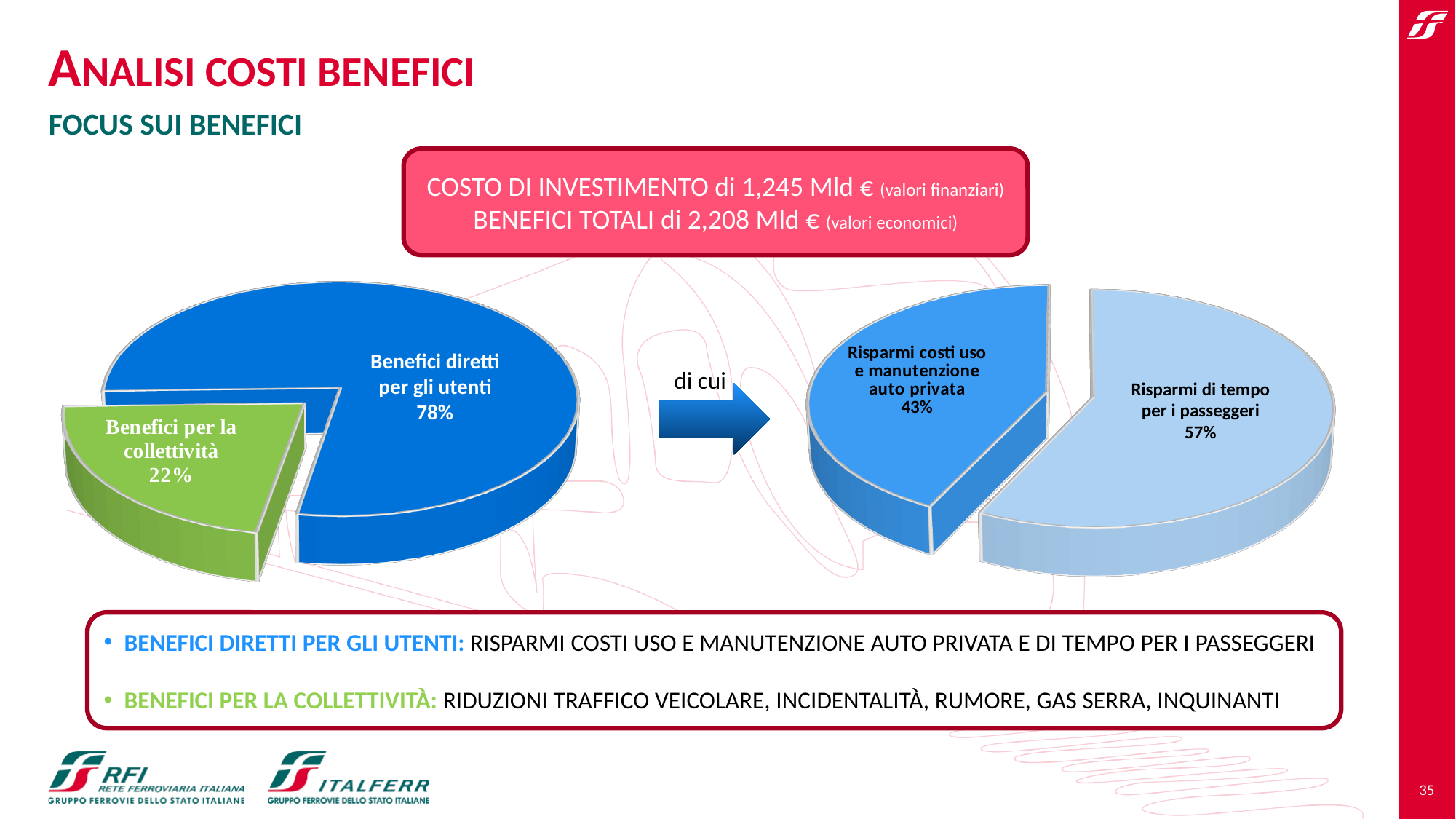
How many slices does the left pie chart have? 2 In the left pie chart, what share is shown for 'Benefici diretti per gli utenti'? 78% In the right pie chart, what share is shown for 'Risparmi di tempo per i passeggeri'? 57% In the right pie chart, what share is shown for 'Risparmi costi uso e manutenzione auto privata'? 43% In the left pie chart, which slice is the largest? Benefici diretti per gli utenti In the right pie chart, which is larger: 'Risparmi di tempo per i passeggeri' or 'Risparmi costi uso e manutenzione auto privata'? Risparmi di tempo per i passeggeri In the right pie chart, what is the difference in percentage points between 'Risparmi di tempo per i passeggeri' and 'Risparmi costi uso e manutenzione auto privata'? 14 percentage points In the left pie chart, what share is shown for 'Benefici per la collettività'? 22% In the left pie chart, what is the difference in percentage points between 'Benefici diretti per gli utenti' and 'Benefici per la collettività'? 56 percentage points What type of chart is used on the right side of the slide? Pie chart In the left pie chart, what colour is the 'Benefici per la collettività' slice? Green In the right pie chart, which slice is the smallest? Risparmi costi uso e manutenzione auto privata